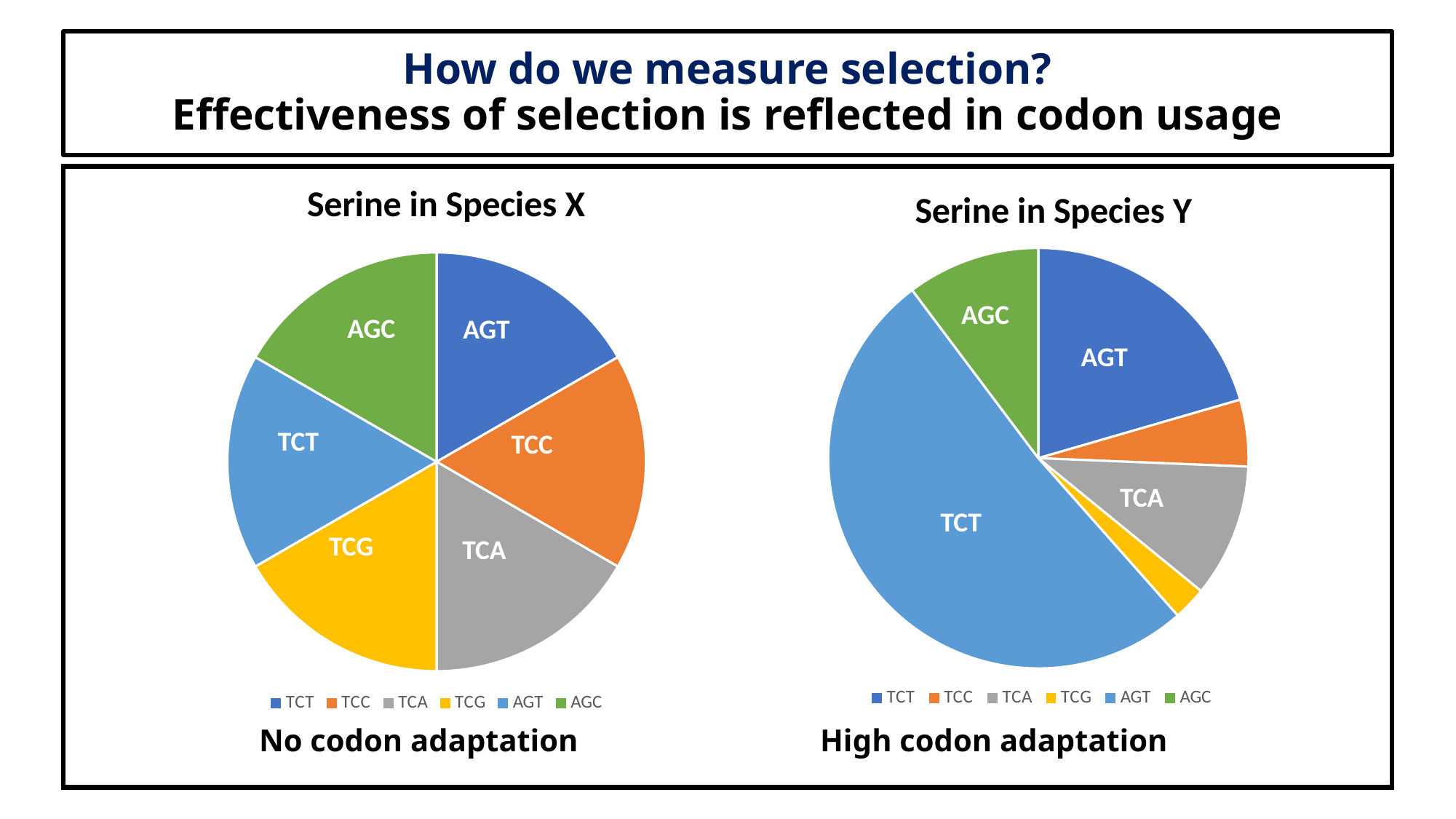
In the "Serine in Species Y" chart, which codon has the smallest slice? TCG What is the title of the left pie chart? Serine in Species X In the "Serine in Species Y" chart, which slice is larger, AGC or TCC? AGC In the "Serine in Species Y" chart, is the TCG slice larger or smaller than the AGC slice? smaller How many charts are shown on the slide? 2 How many entries does the legend of the "Serine in Species Y" chart list? 6 In the "Serine in Species Y" chart, which slice is larger, TCA or TCC? TCA How many slices does the "Serine in Species X" pie chart have? 6 What caption appears below the "Serine in Species Y" chart? High codon adaptation What kind of chart is "Serine in Species X"? pie chart